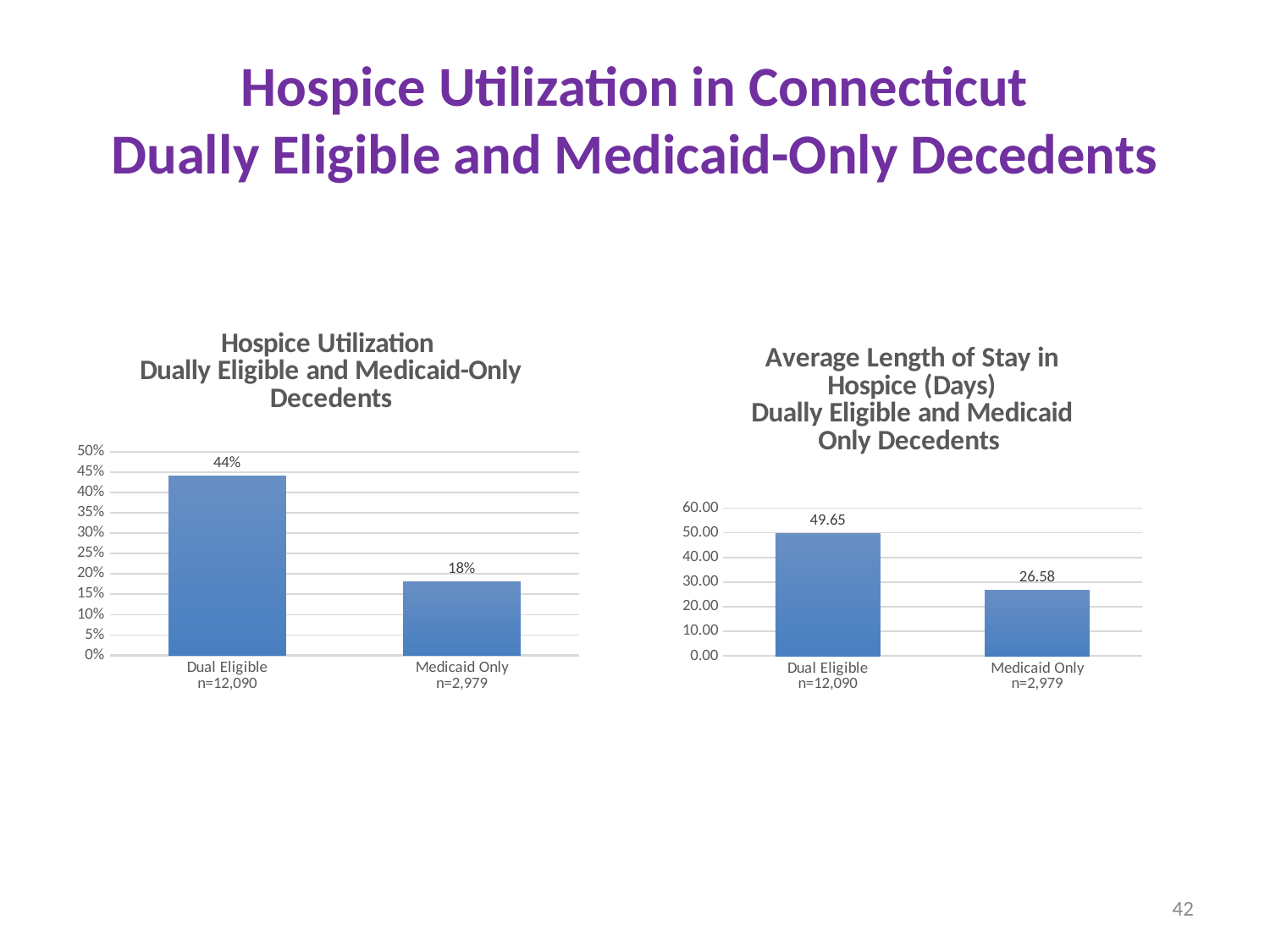
What is the sample size (n) shown for the Medicaid Only category in the left chart (Hospice Utilization)? n=2,979 How many categories are shown in the left chart (Hospice Utilization)? 2 In the left chart (Hospice Utilization), what is the difference between the Dual Eligible and Medicaid Only values? 26% In the right chart (Average Length of Stay in Hospice), is the value for Dual Eligible greater or less than 40.00? greater In the right chart (Average Length of Stay in Hospice), what is the value for Dual Eligible? 49.65 In the left chart (Hospice Utilization), what is the value for Medicaid Only? 18% In the right chart (Average Length of Stay in Hospice), what is the difference between the Dual Eligible and Medicaid Only values? 23.07 What kind of chart is the right chart (Average Length of Stay in Hospice)? Bar chart In the right chart (Average Length of Stay in Hospice), what is the value for Medicaid Only? 26.58 In the left chart (Hospice Utilization), what is the value for Dual Eligible? 44% In the right chart (Average Length of Stay in Hospice), which category has the lowest value? Medicaid Only In the left chart (Hospice Utilization), which category has the highest value? Dual Eligible